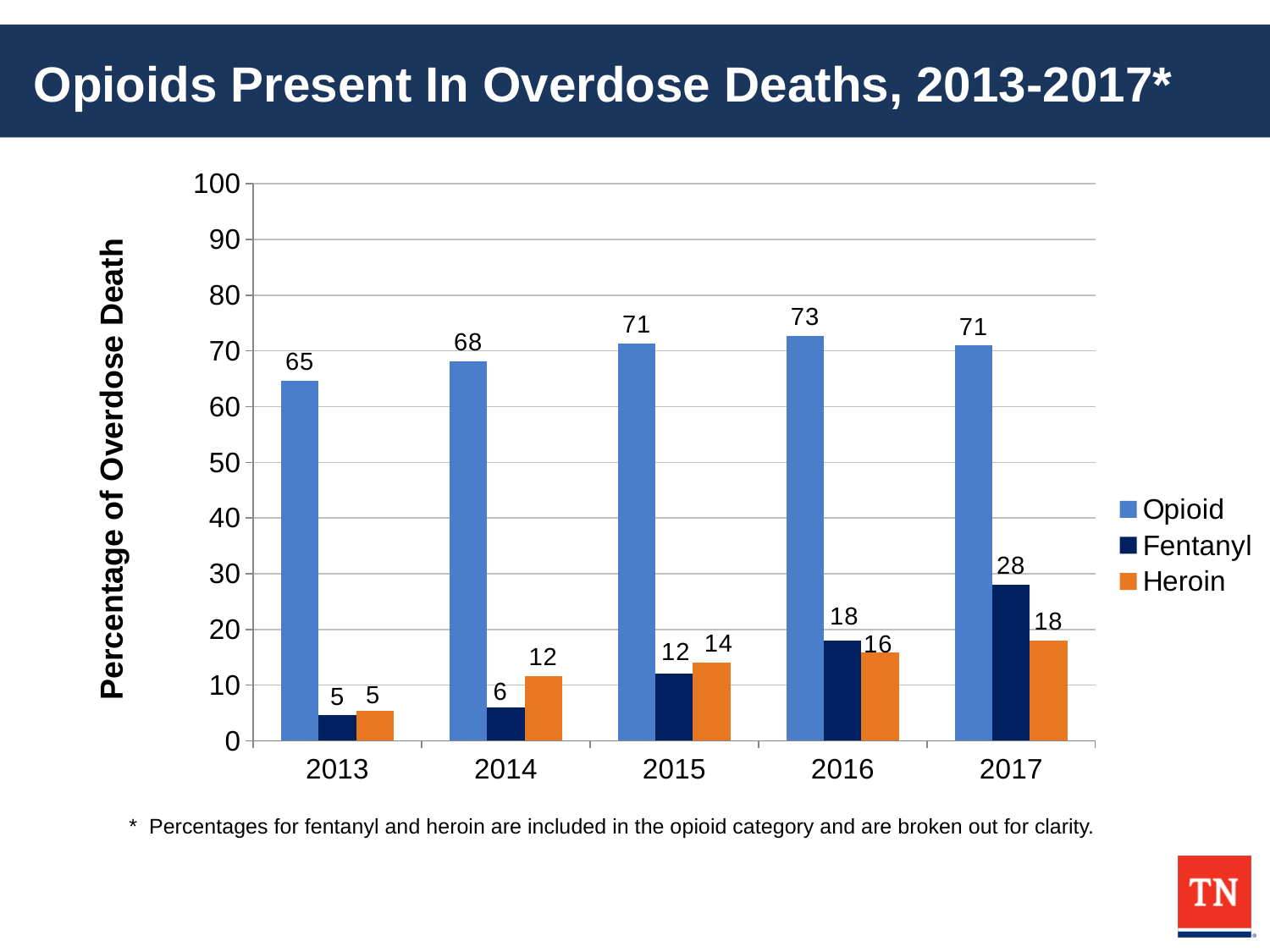
Does the Fentanyl value rise or fall from 2013 to 2017? rise In which year is the Opioid value highest? 2016 In which year is the Fentanyl value lowest? 2013 What kind of chart is shown on the slide? bar chart What is the Opioid value for 2016? 73 Is the Opioid value for 2014 greater or less than 60? greater How many years are shown on the x axis? 5 Which is larger in 2015, the Fentanyl value or the Heroin value? Heroin What is the Heroin value for 2014? 12 How many series does the legend list? 3 What is the difference between the Opioid value in 2017 and the Opioid value in 2013? 6 What is the Fentanyl value for 2017? 28